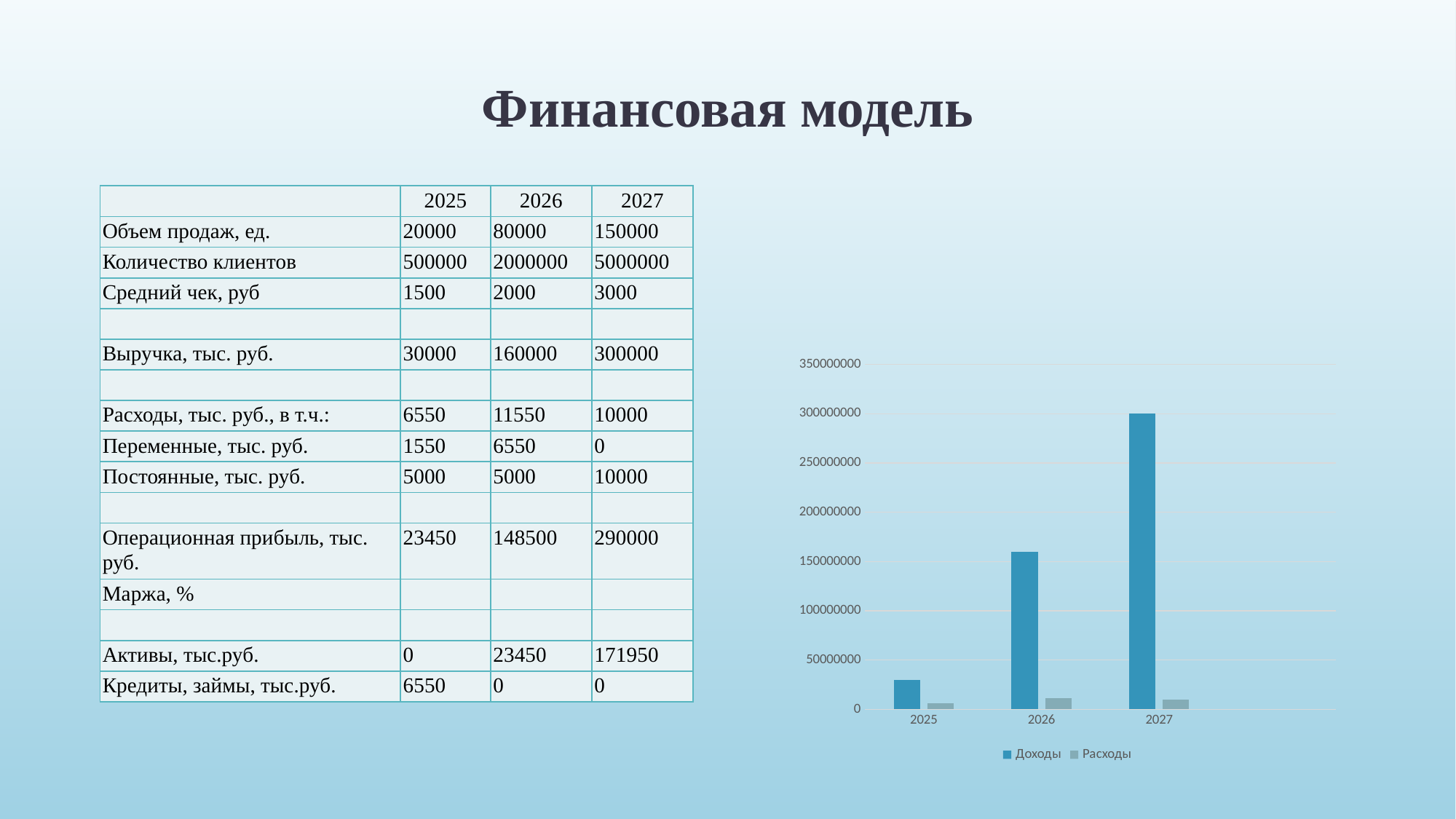
Do the Доходы values rise or fall from 2025 to 2027? rise Is the Расходы value for 2027 greater or less than 50000000? less What kind of chart is shown on the slide? bar chart How many series does the chart legend list? 2 In 2026, which is larger: Доходы or Расходы? Доходы Is the Доходы value for 2026 greater or less than 100000000? greater What is the highest value shown on the chart's vertical axis? 350000000 How many years are shown on the x axis of the chart? 3 Is the Доходы value for 2025 greater or less than 50000000? less Which year has the highest Доходы bar? 2027 Which year has the lowest Доходы bar? 2025 What are the two series named in the chart legend? Доходы, Расходы